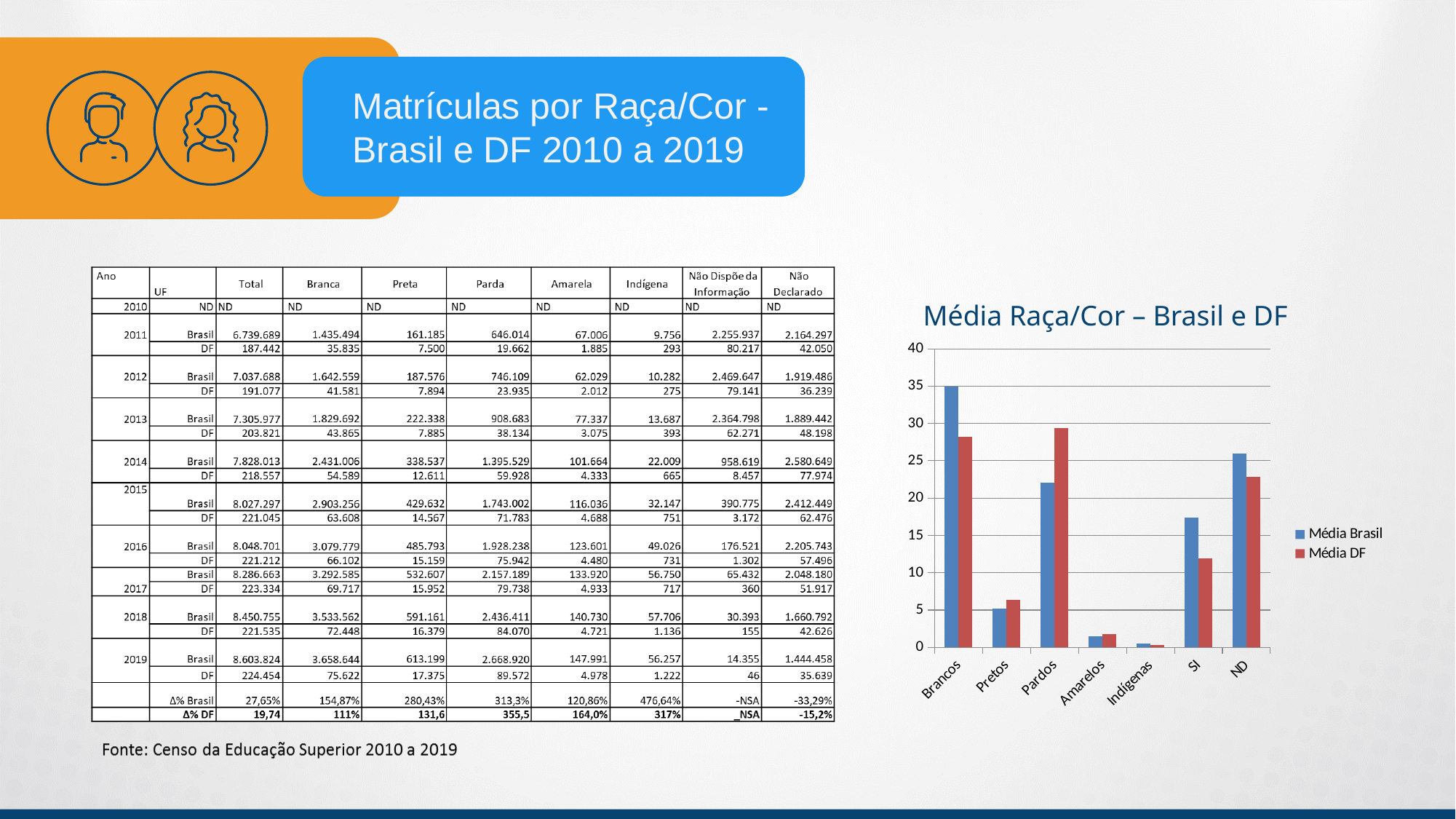
Which colour represents the Média DF series in the chart? red For the Brancos category, which series has the larger value, Média Brasil or Média DF? Média Brasil For the Pardos category, which series has the larger value, Média Brasil or Média DF? Média DF Which category has the highest value for the Média DF series? Pardos How many categories are shown on the x axis of the chart? 7 What is the title of the chart? Média Raça/Cor – Brasil e DF Which category has the highest value for the Média Brasil series? Brancos How many series does the legend of the chart list? 2 Is the Média DF value for SI greater or less than 15? less Which category has the lowest value for the Média Brasil series? Indígenas What kind of chart is shown on the slide? bar chart Is the Média Brasil value for Brancos greater or less than 30? greater